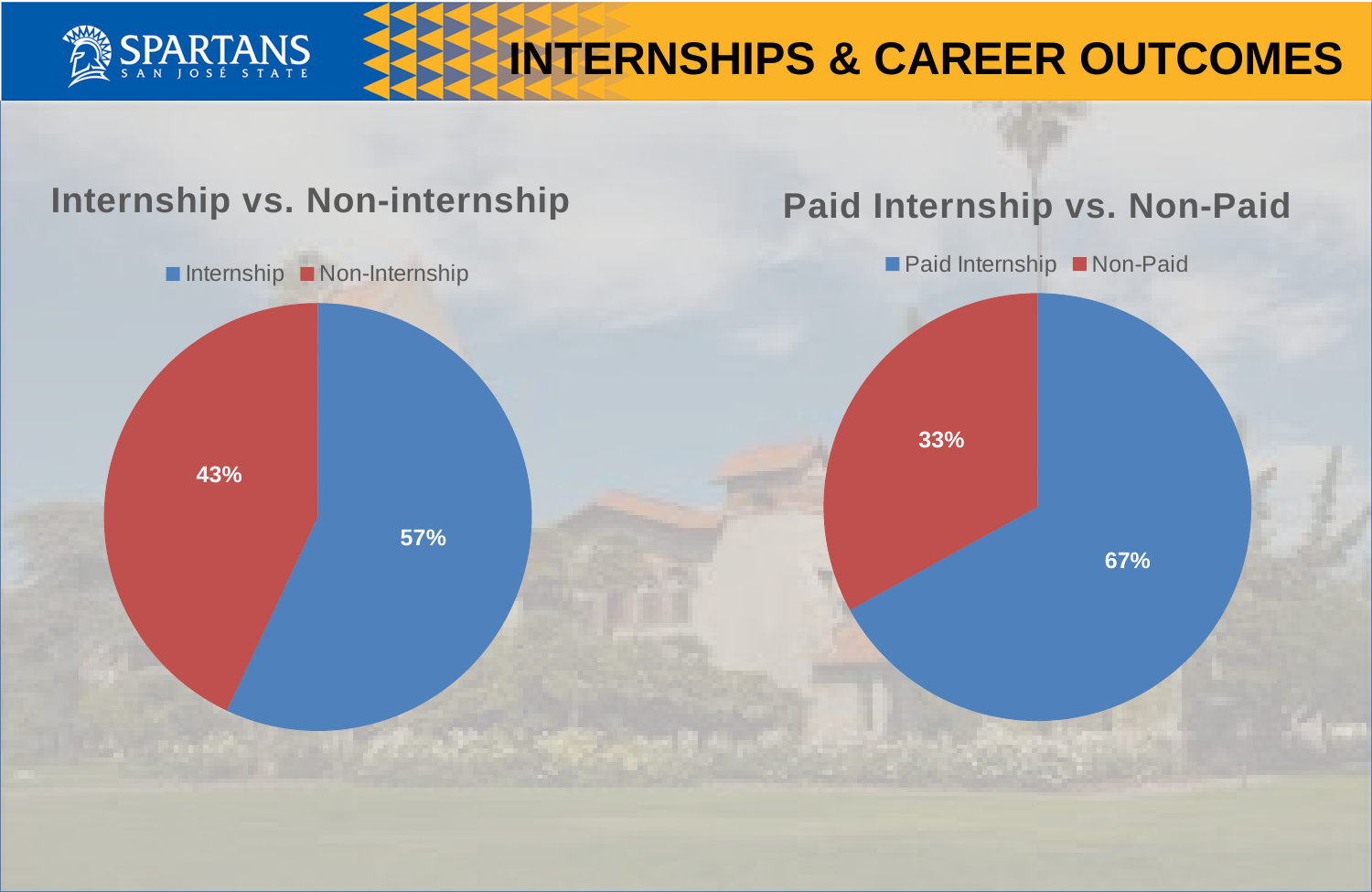
In the 'Internship vs. Non-internship' chart, which slice is the largest? Internship In the 'Paid Internship vs. Non-Paid' chart, what percentage is shown for Non-Paid? 33% In the 'Internship vs. Non-internship' chart, what percentage is shown for Internship? 57% How many slices does the 'Paid Internship vs. Non-Paid' chart have? 2 In the 'Internship vs. Non-internship' chart, what colour is the Non-Internship slice? Red In the 'Paid Internship vs. Non-Paid' chart, what is the difference between the Paid Internship and Non-Paid percentages? 34% In the 'Paid Internship vs. Non-Paid' chart, which is larger: Paid Internship or Non-Paid? Paid Internship What type of chart is the 'Internship vs. Non-internship' chart? Pie chart In the 'Internship vs. Non-internship' chart, what percentage is shown for Non-Internship? 43% In the 'Paid Internship vs. Non-Paid' chart, which slice is the smallest? Non-Paid In the 'Paid Internship vs. Non-Paid' chart, what percentage is shown for Paid Internship? 67% In the 'Internship vs. Non-internship' chart, what is the difference between the Internship and Non-Internship percentages? 14%